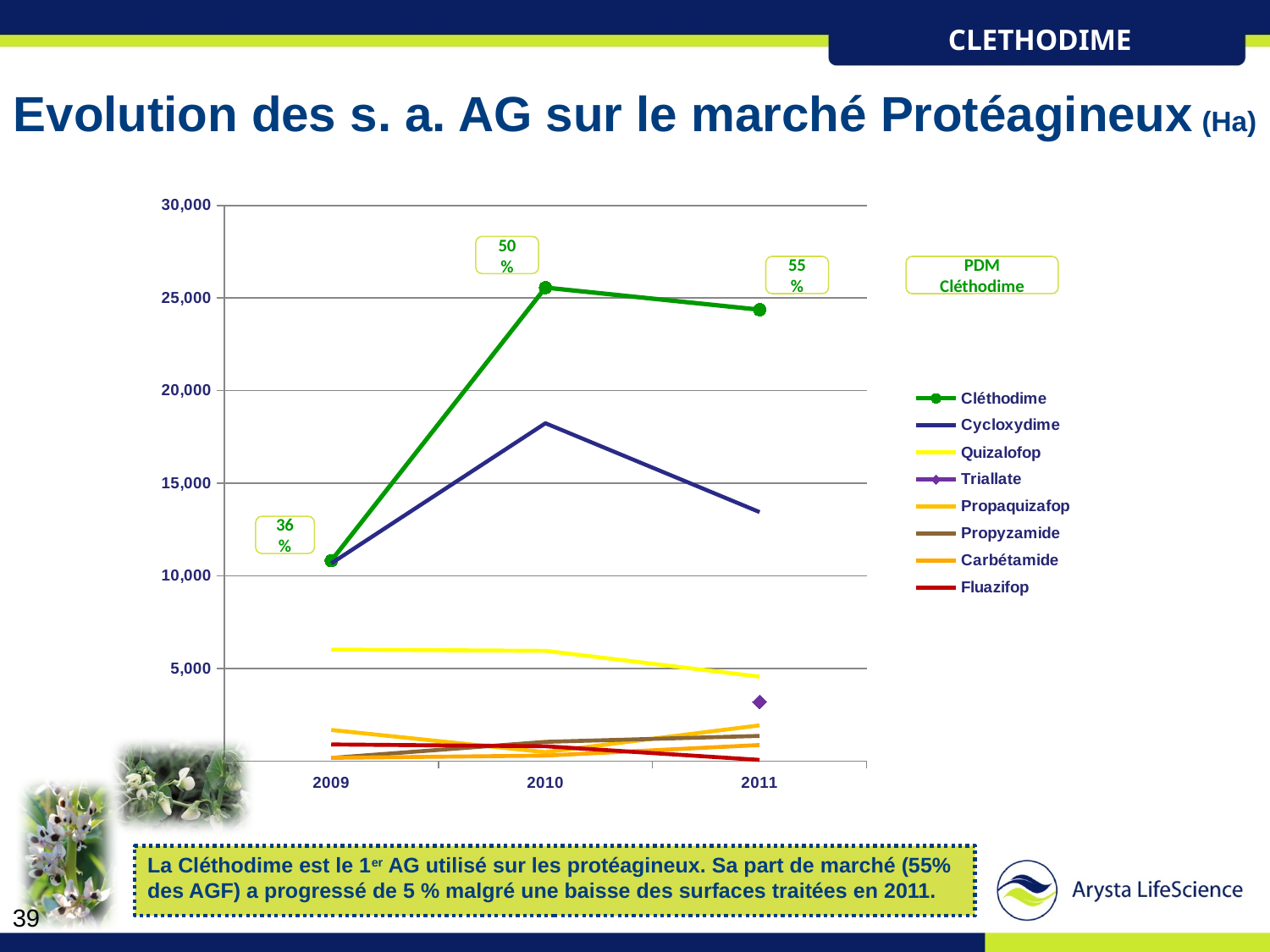
Which series has the highest value in 2010? Cléthodime How many years are shown on the x axis? 3 Is the value for Cycloxydime in 2011 greater or less than 15,000? less What kind of chart is shown on the slide? line chart Is the value for Quizalofop in 2009 greater or less than 5,000? greater How many series does the legend list? 8 Is the value for Cycloxydime in 2010 greater or less than 20,000? less What PDM (market share) label is shown for Cléthodime in 2011? 55 % Which is larger in 2011, Cléthodime or Cycloxydime? Cléthodime Does the Quizalofop line rise or fall from 2009 to 2011? fall